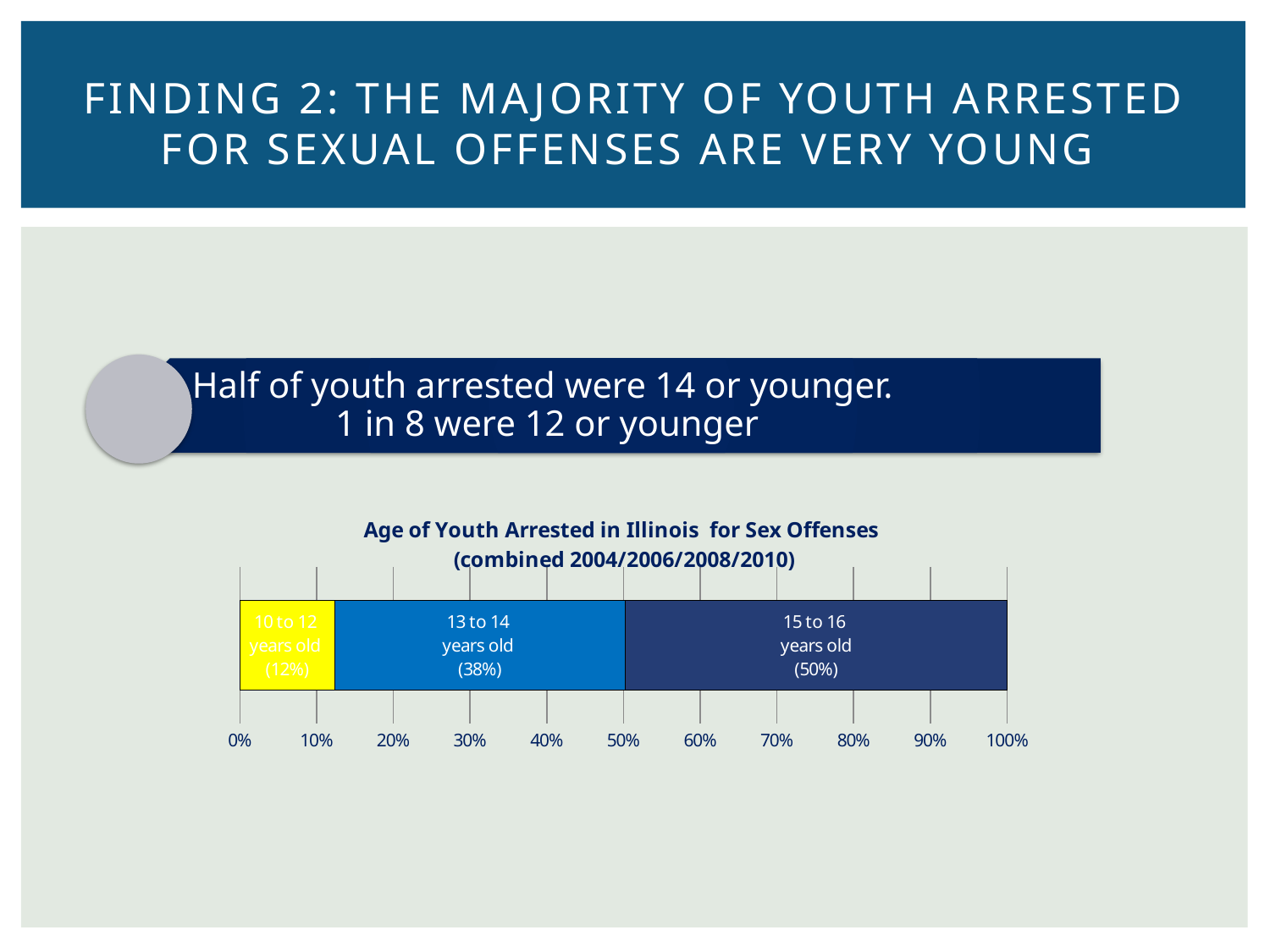
What is the difference in percentage points between the 13 to 14 years old group and the 10 to 12 years old group? 26 Which age group has the smallest share of youth arrested? 10 to 12 years old What is the difference in percentage points between the 15 to 16 years old group and the 13 to 14 years old group? 12 What percentage of youth arrested were 10 to 12 years old? 12% What type of chart is shown on the slide? Stacked bar chart What is the title of the chart? Age of Youth Arrested in Illinois for Sex Offenses (combined 2004/2006/2008/2010) What percentage of youth arrested were 15 to 16 years old? 50% How many age groups are shown in the bar? 3 What percentage of youth arrested were 13 to 14 years old? 38% Which is larger, the share for 13 to 14 years old or the share for 10 to 12 years old? 13 to 14 years old Which age group has the largest share of youth arrested? 15 to 16 years old What is the combined percentage of the 10 to 12 and 13 to 14 years old groups? 50%